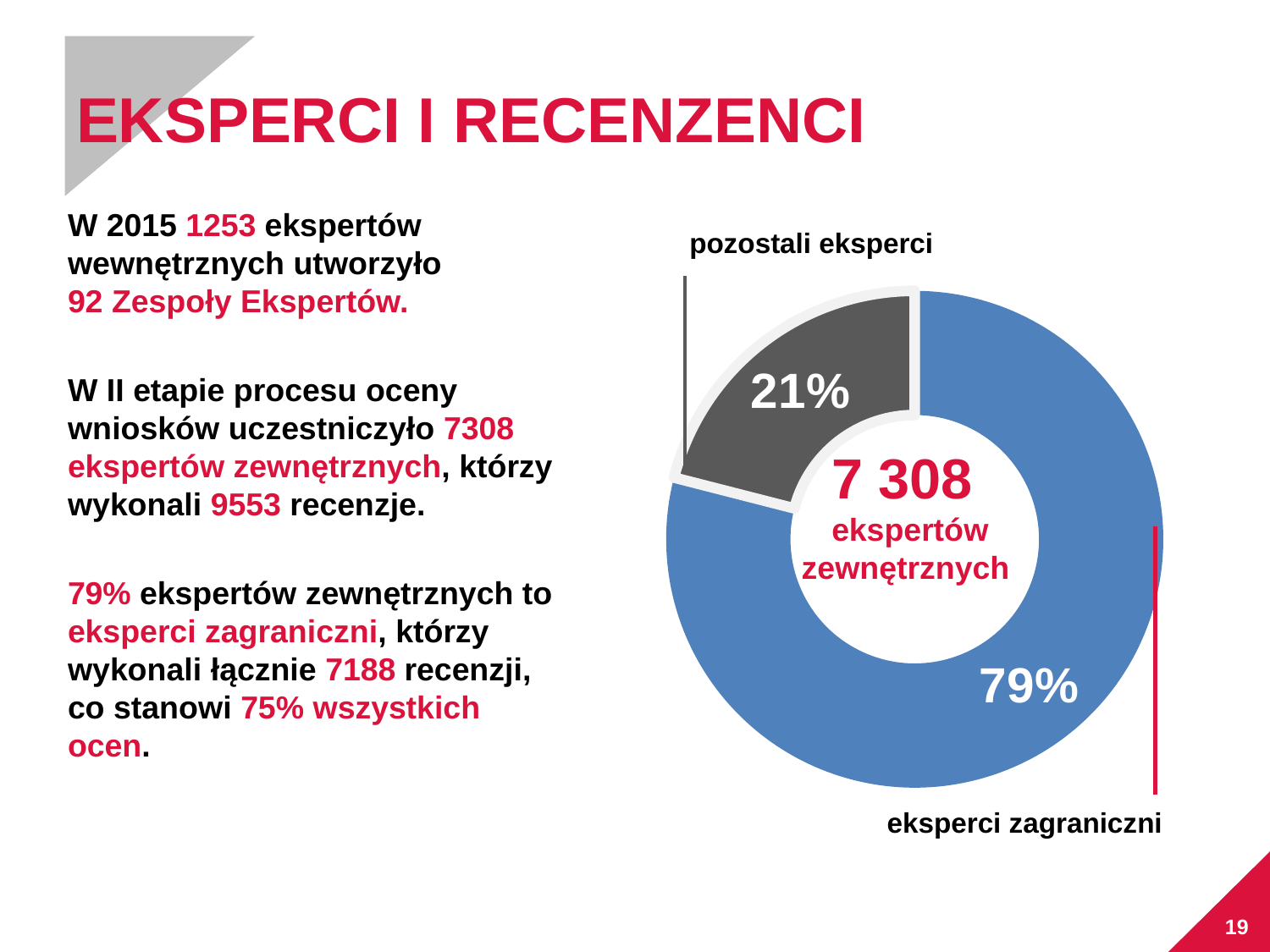
What is the total of the two shares shown in the chart? 100% How many categories does the chart show? 2 Which category has the smallest share in the chart? pozostali eksperci Which is larger: the share for "eksperci zagraniczni" or for "pozostali eksperci"? eksperci zagraniczni Which category has the largest share in the chart? eksperci zagraniczni What kind of chart is shown on the slide? Doughnut (pie) chart What is the difference in percentage points between the "eksperci zagraniczni" and "pozostali eksperci" shares? 58 percentage points What number is printed in the centre of the doughnut chart? 7 308 What share of the chart is labelled "eksperci zagraniczni"? 79% What share of the chart is labelled "pozostali eksperci"? 21% What colour is the "eksperci zagraniczni" segment of the chart? Blue